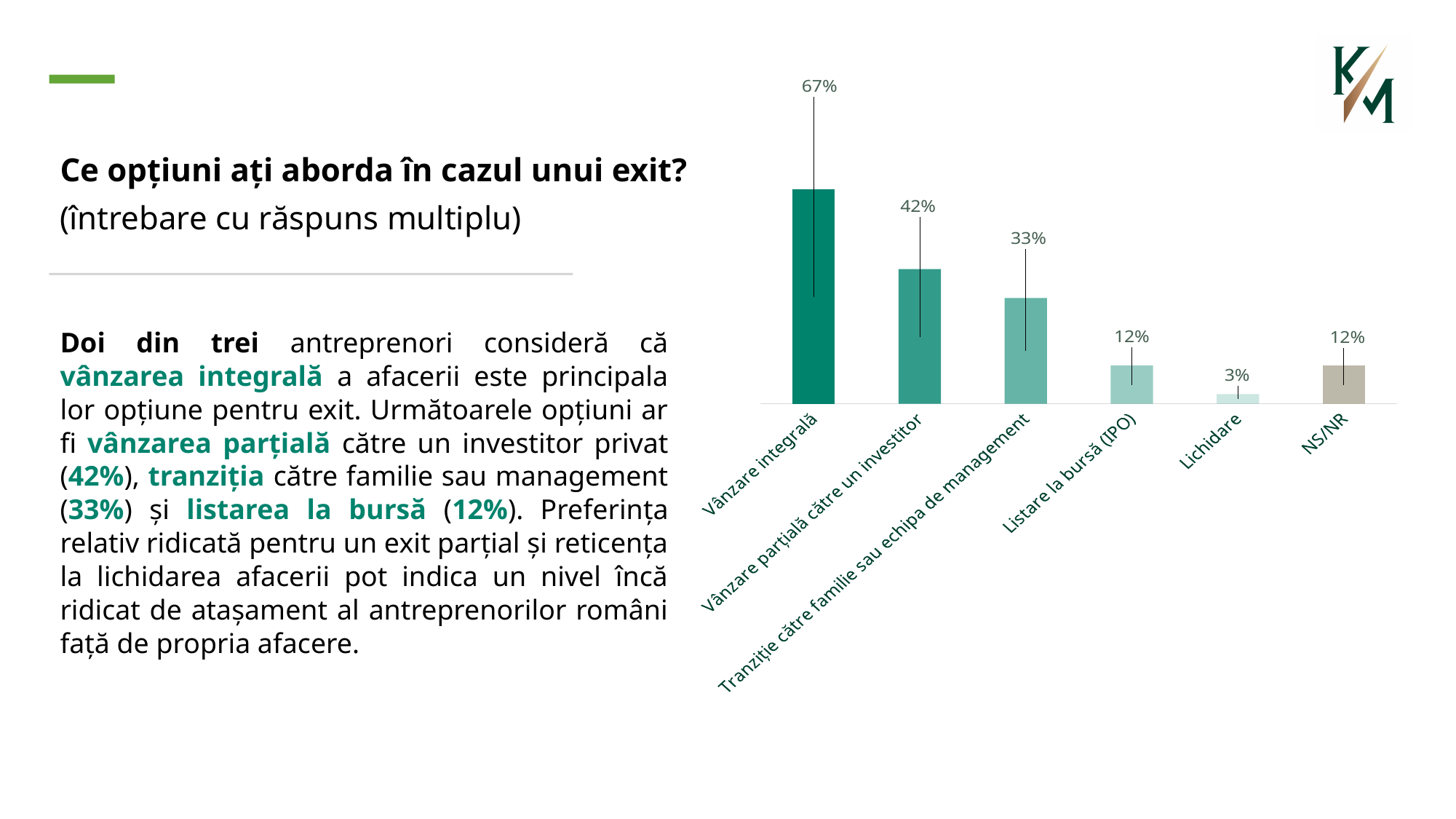
What is the value for NS/NR? 12% What is the difference between the values for Listare la bursă (IPO) and Lichidare? 9% What is the value for Tranziție către familie sau echipa de management? 33% Which category has the lowest value? Lichidare What is the value for Vânzare integrală? 67% What is the value for Vânzare parțială către un investitor? 42% What kind of chart is shown on the slide? Bar chart How many categories are shown in the chart? 6 Which is larger, the value for Tranziție către familie sau echipa de management or the value for Listare la bursă (IPO)? Tranziție către familie sau echipa de management What is the difference between the values for Vânzare integrală and Vânzare parțială către un investitor? 25% Which category has the highest value? Vânzare integrală What is the value for Lichidare? 3%